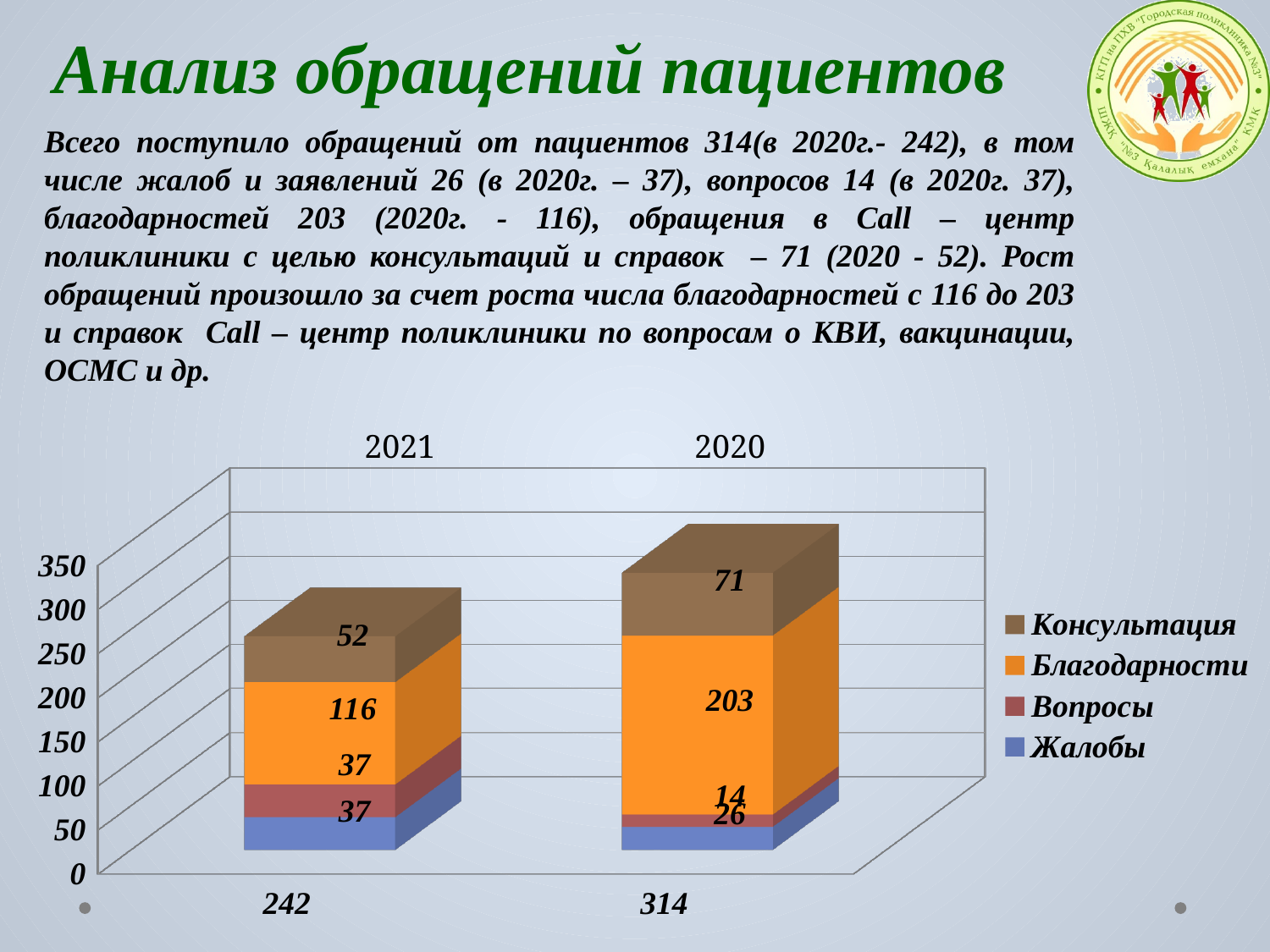
How many bars are plotted in the chart? 2 What is the total of the stacked bar labelled 314? 314 Which legend entry is shown in orange? Благодарности Which series has the largest segment in the bar labelled 314? Благодарности How many series does the chart legend list? 4 Which bar has the larger Вопросы value, the one labelled 242 or the one labelled 314? 242 What is the value of the Вопросы segment in the bar labelled 242? 37 What is the value of the Жалобы segment in the bar labelled 314? 26 What is the value of the Благодарности segment in the bar labelled 314? 203 What is the difference between the Благодарности values of the two bars (203 and 116)? 87 What is the value of the Консультация segment in the bar labelled 242? 52 What kind of chart is shown on the slide? stacked bar chart